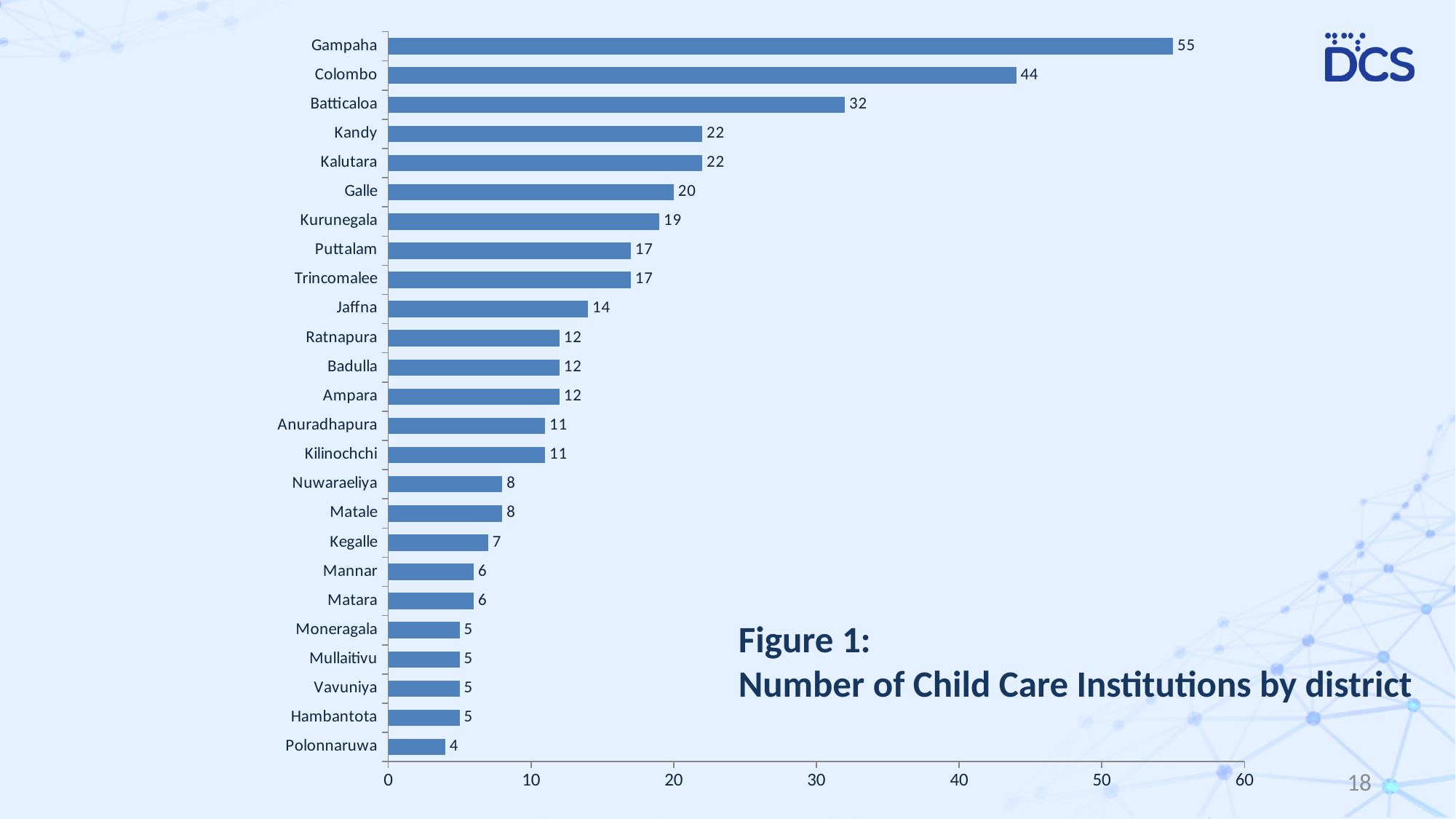
What is the number of child care institutions in Batticaloa? 32 How many districts are shown in the chart? 25 Which district has the lowest number of child care institutions? Polonnaruwa What is the difference between the number of child care institutions in Gampaha and Colombo? 11 What is the number of child care institutions in Jaffna? 14 What is the title of the figure on the slide? Figure 1: Number of Child Care Institutions by district What is the difference between the number of child care institutions in Kandy and Galle? 2 What is the number of child care institutions in Gampaha? 55 Which district has the highest number of child care institutions? Gampaha Is the value for Colombo greater or less than 40? greater What kind of chart is shown on the slide? Bar chart Which district has more child care institutions, Kurunegala or Puttalam? Kurunegala